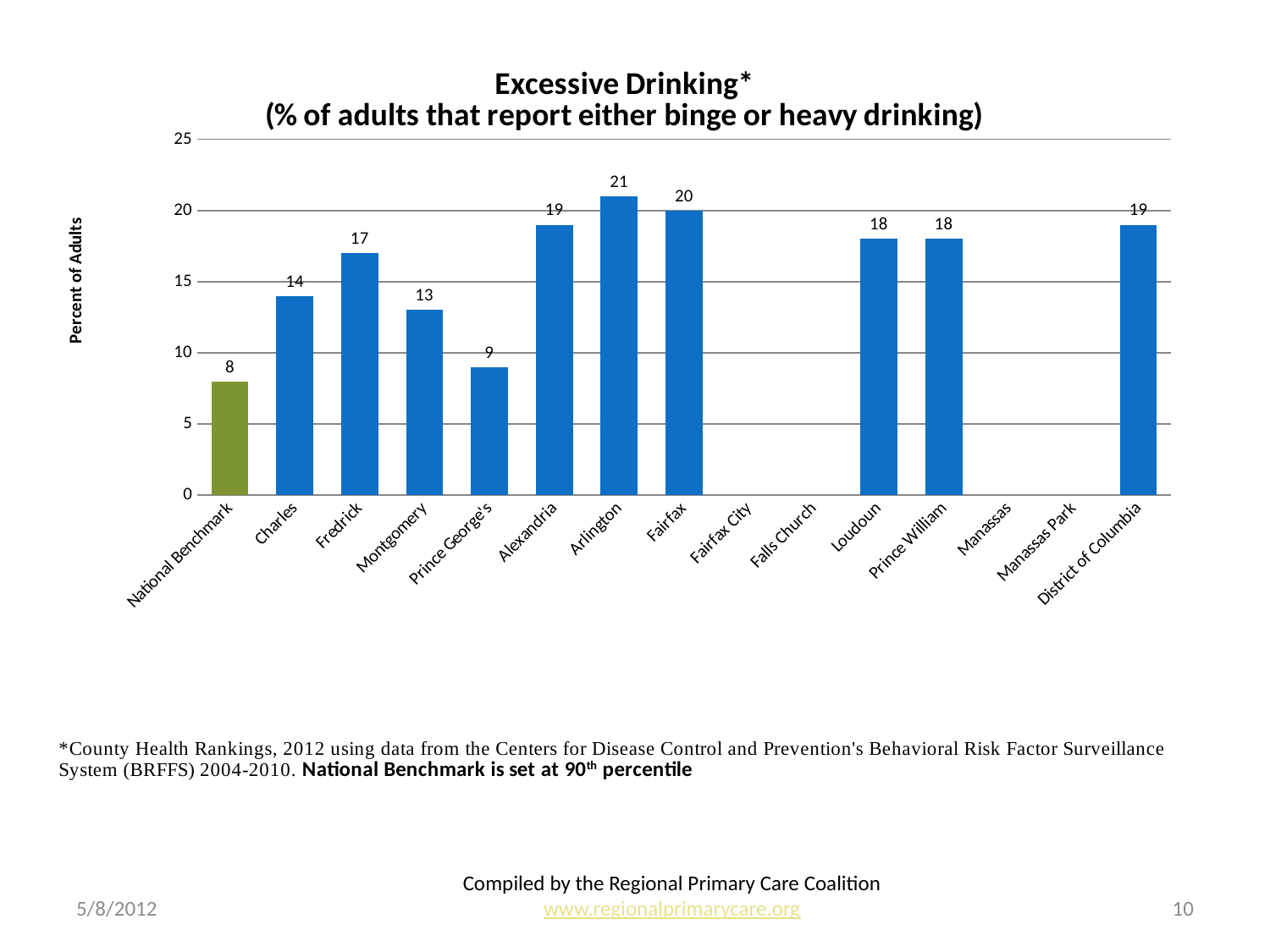
What is the value for the National Benchmark? 8 What is the value for Prince George's? 9 What kind of chart is shown? Bar chart Which category has the highest value? Arlington How many categories are labeled on the x axis? 15 Is the value for Alexandria greater or less than 15? greater Which category has the lowest value among those with a bar shown? National Benchmark Which is larger, the value for Fredrick or the value for Montgomery? Fredrick What is the value for Loudoun? 18 What is the label of the y axis? Percent of Adults What is the difference between the values for Fairfax and Charles? 6 What is the value for Arlington? 21